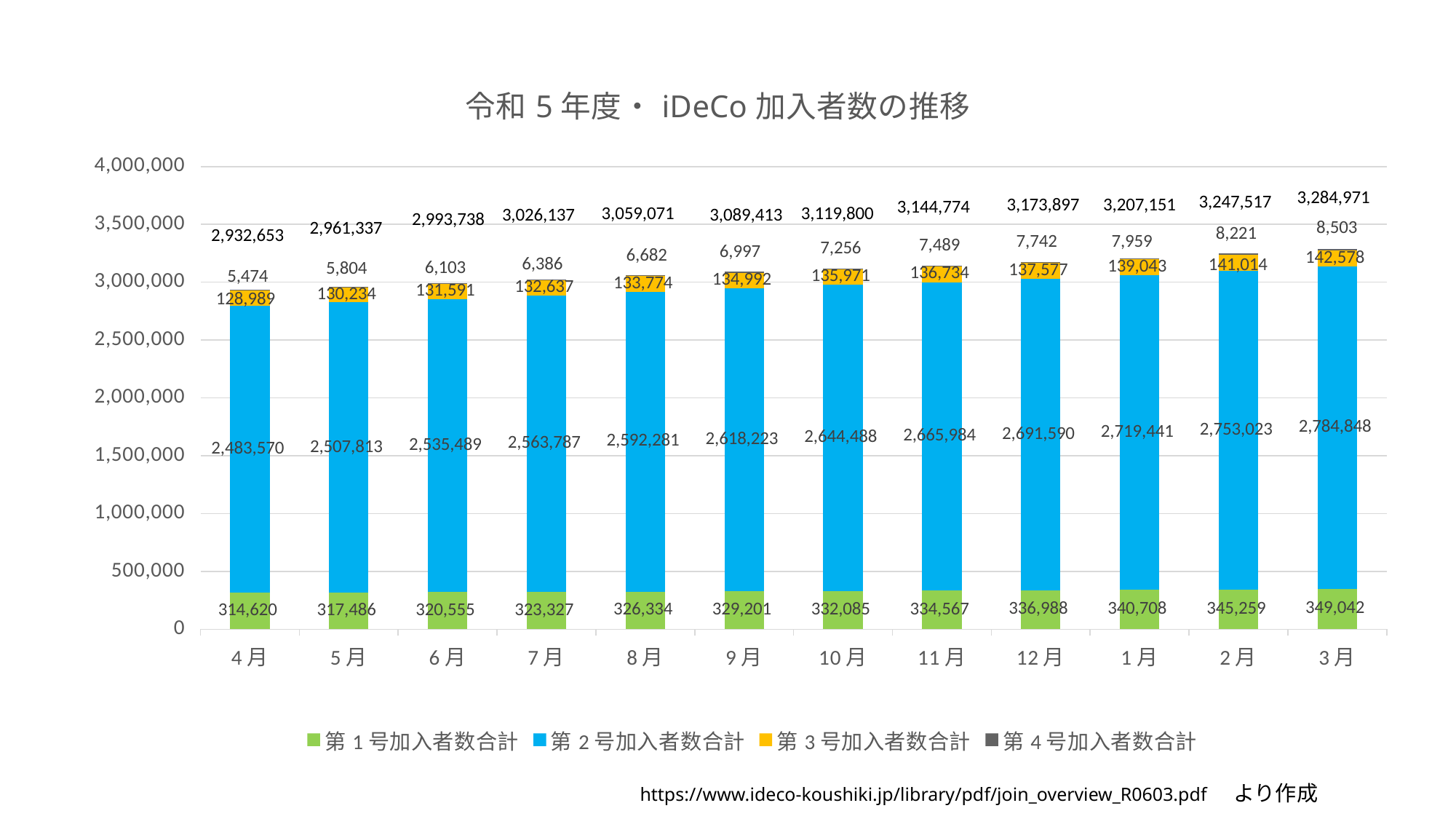
What is the value of 第１号加入者数合計 for 10月? 332,085 Do the total participant numbers rise or fall from 4月 to 3月? rise Which month has the highest value for 第２号加入者数合計? 3月 What is the difference between the 第２号加入者数合計 values for 3月 and 4月? 301,278 What is the value of 第３号加入者数合計 for 2月? 141,014 What is the value of 第２号加入者数合計 for 4月? 2,483,570 Which is larger, the 第１号加入者数合計 value for 12月 or for 1月? 1月 How many series does the legend list? 4 What is the value of 第４号加入者数合計 for 7月? 6,386 Which month has the lowest total number of participants? 4月 What is the total of the stacked bar for 3月? 3,284,971 How many months are shown on the x axis? 12